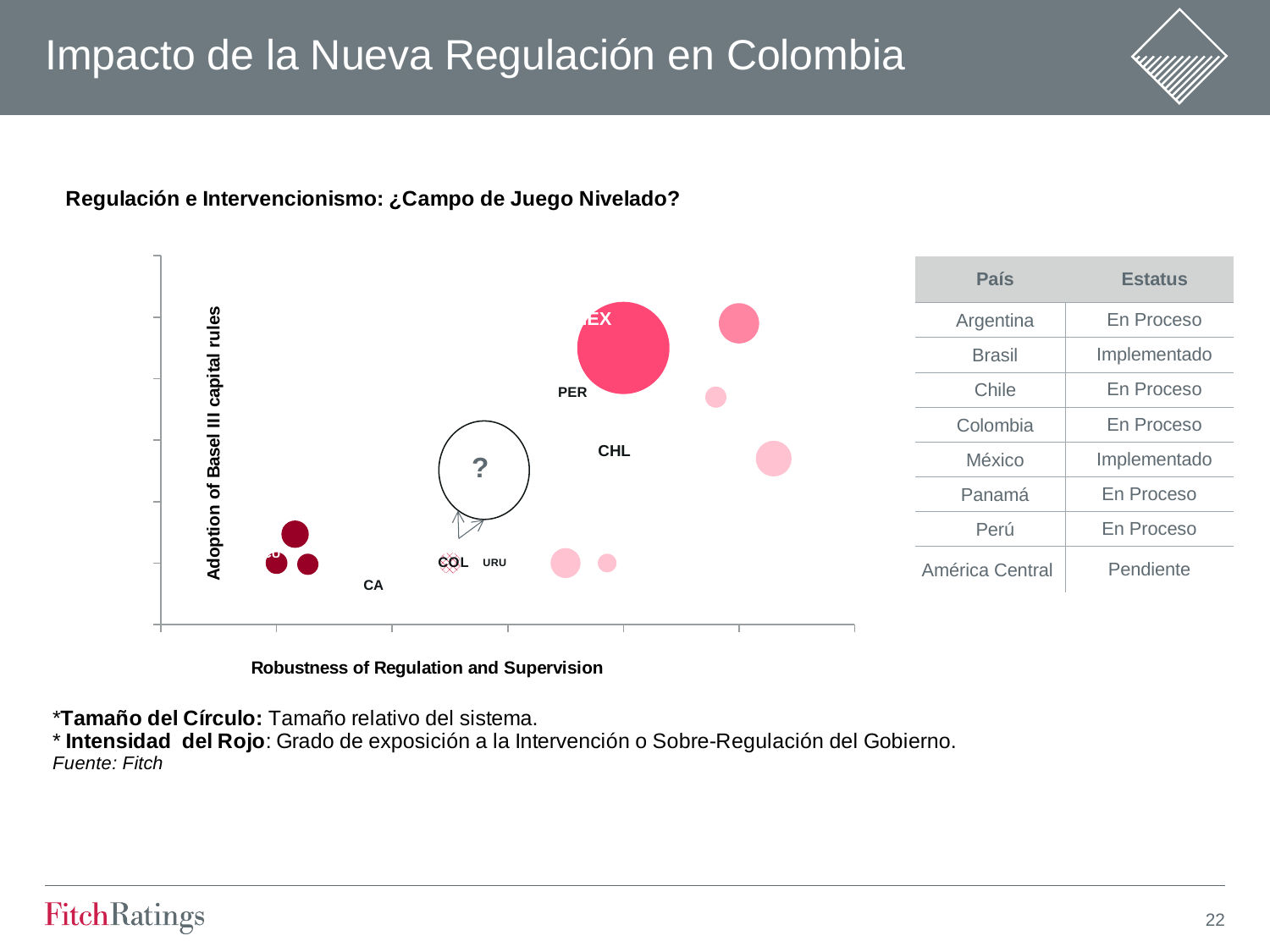
What is the title of the vertical axis of the chart? Adoption of Basel III capital rules Which is positioned higher on the Adoption of Basel III capital rules axis, CHL or URU? CHL What symbol is printed inside the outlined circle in the middle of the chart? ? Which is positioned higher on the Adoption of Basel III capital rules axis, PER or COL? PER Which is positioned further right on the Robustness of Regulation and Supervision axis, COL or CA? COL What kind of chart is shown on the slide? Bubble chart What is the title of the horizontal axis of the chart? Robustness of Regulation and Supervision